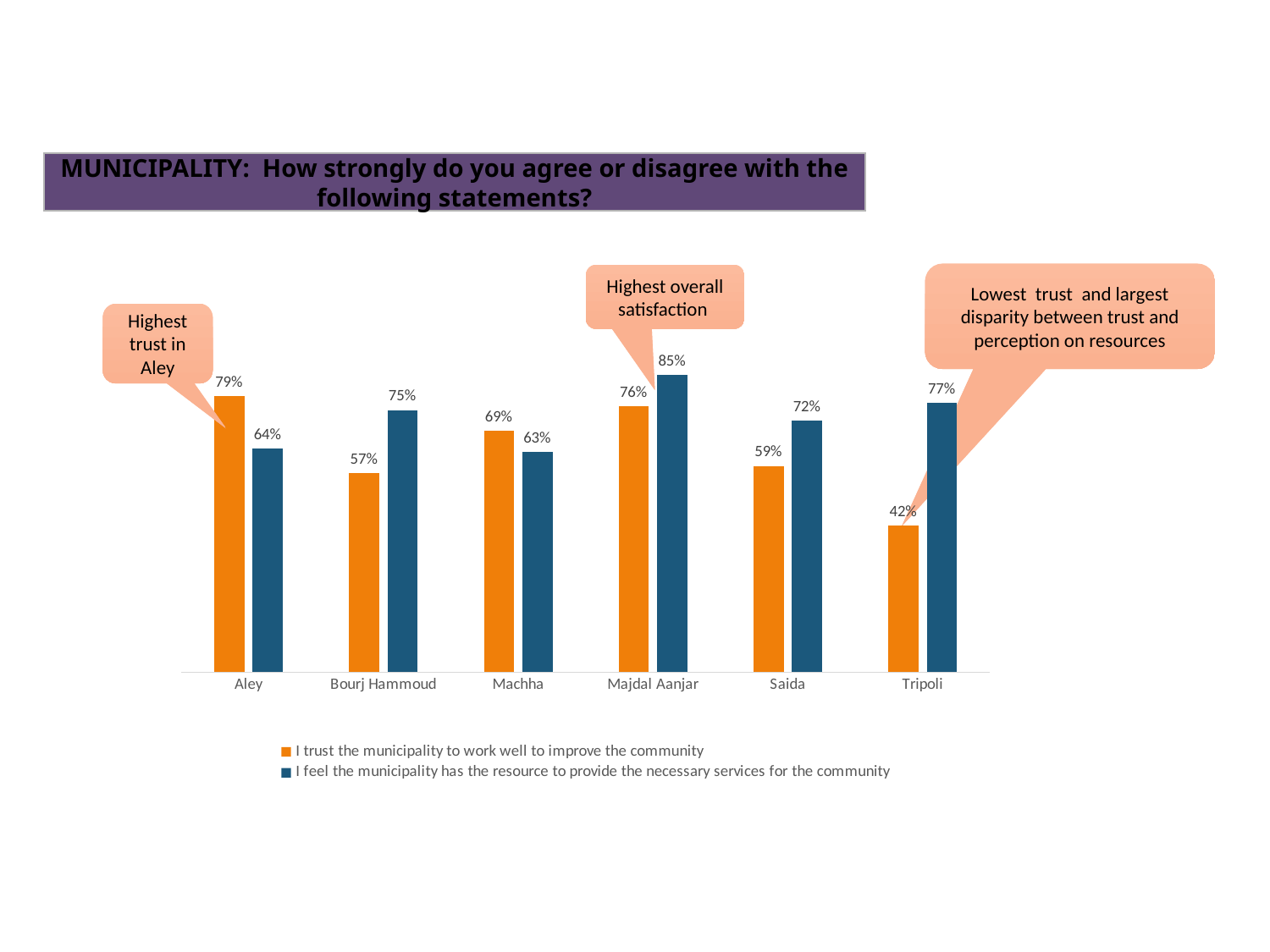
What is the difference between the two series values for Tripoli? 35% How many municipalities are shown on the x axis? 6 How many series does the legend list? 2 Which colour represents the series 'I trust the municipality to work well to improve the community'? Orange What kind of chart is shown on the slide? Bar chart Which municipality has the highest value for 'I trust the municipality to work well to improve the community'? Aley What is the value for Aley in the series 'I trust the municipality to work well to improve the community'? 79% Which municipality has the lowest value for 'I feel the municipality has the resource to provide the necessary services for the community'? Machha What is the value for Tripoli in the series 'I trust the municipality to work well to improve the community'? 42% What is the value for Majdal Aanjar in the series 'I feel the municipality has the resource to provide the necessary services for the community'? 85% Which is larger for Bourj Hammoud: the trust value or the resources value? The resources value (75%) What is the difference between the trust values for Aley and Tripoli? 37%